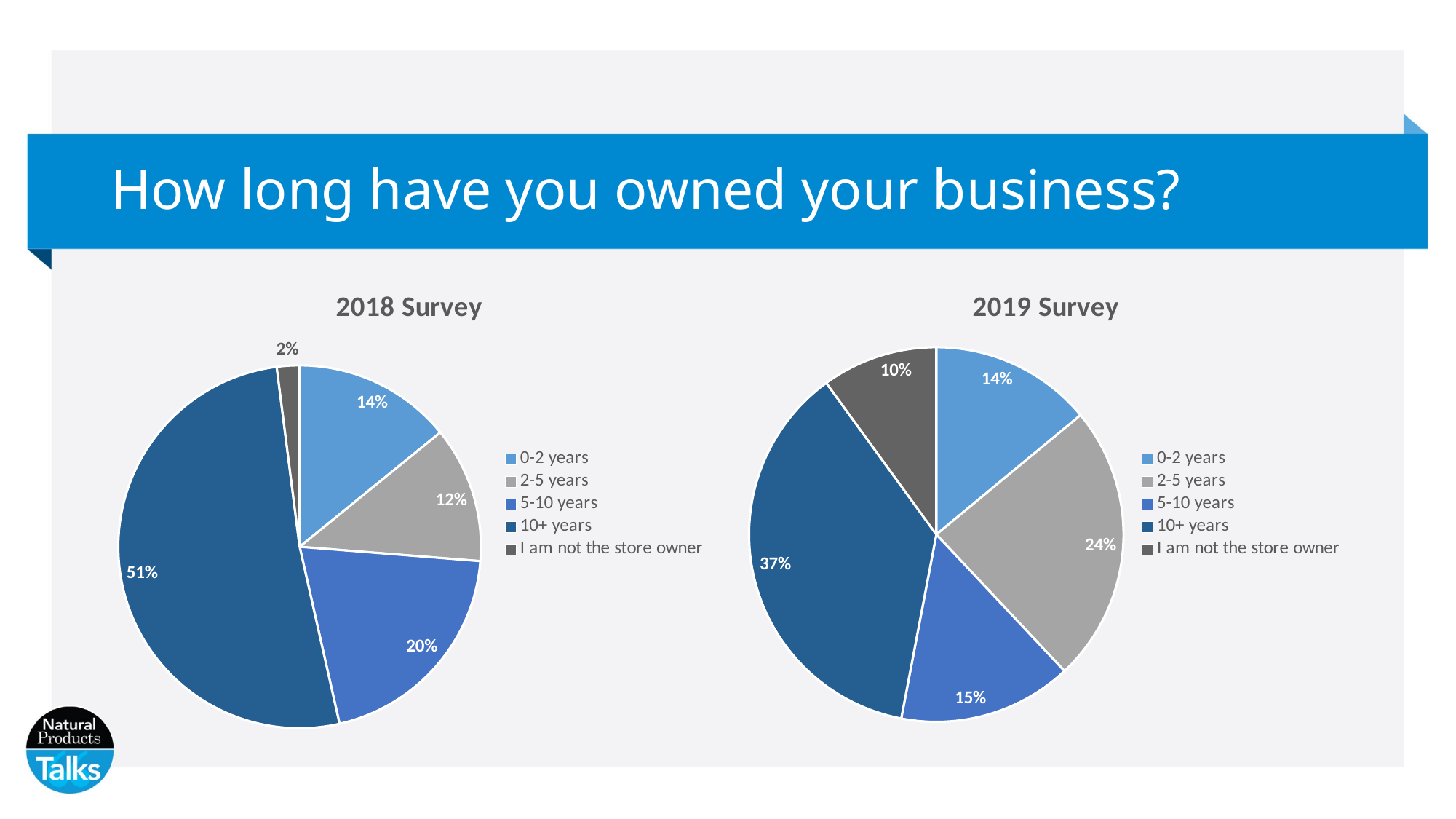
In the 2018 Survey chart, what share of respondents have owned their business for 10+ years? 51% What type of chart is the 2019 Survey chart? Pie chart How many entries does the legend of the 2018 Survey chart list? 5 In the 2018 Survey chart, which category has the smallest slice? I am not the store owner In the 2019 Survey chart, which is larger: the 2-5 years slice or the 5-10 years slice? 2-5 years In the 2019 Survey chart, which category has the largest slice? 10+ years In the 2019 Survey chart, what share of respondents have owned their business for 2-5 years? 24% How many slices does the 2018 Survey pie chart have? 5 In the 2018 Survey chart, what share of respondents are not the store owner? 2% In the 2019 Survey chart, what is the combined share of the 0-2 years and 5-10 years slices? 29% What is the difference between the 10+ years share in the 2018 Survey chart and the 10+ years share in the 2019 Survey chart? 14% In the 2019 Survey chart, which category has the smallest slice? I am not the store owner